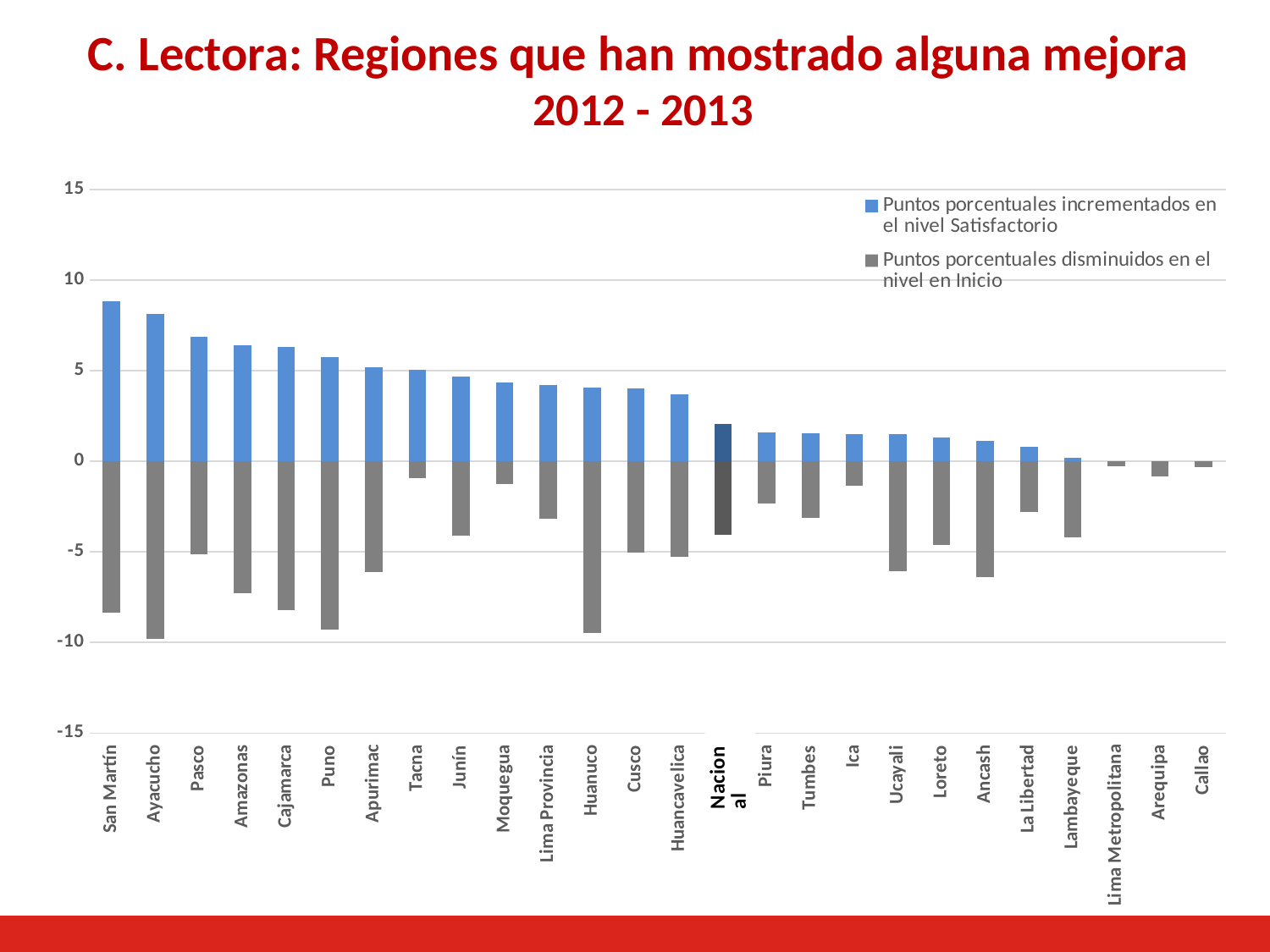
How many series does the legend list? 2 Which region shows the larger decrease in the 'Puntos porcentuales disminuidos en el nivel en Inicio' series, Amazonas or Tacna? Amazonas Is the value for Tacna in the 'Puntos porcentuales disminuidos en el nivel en Inicio' series greater or less than -5? greater How many categories are shown along the x axis? 26 Which region has the highest value for 'Puntos porcentuales incrementados en el nivel Satisfactorio'? San Martín What colour represents 'Puntos porcentuales incrementados en el nivel Satisfactorio' in the legend? blue Which has the larger value for 'Puntos porcentuales incrementados en el nivel Satisfactorio', San Martín or Piura? San Martín Is the value for Ayacucho in the 'Puntos porcentuales disminuidos en el nivel en Inicio' series greater or less than -5? less Do the values for 'Puntos porcentuales incrementados en el nivel Satisfactorio' rise or fall from left to right along the x axis? fall Is the value for Piura in the 'Puntos porcentuales incrementados en el nivel Satisfactorio' series greater or less than 5? less What kind of chart is shown on the slide? bar chart